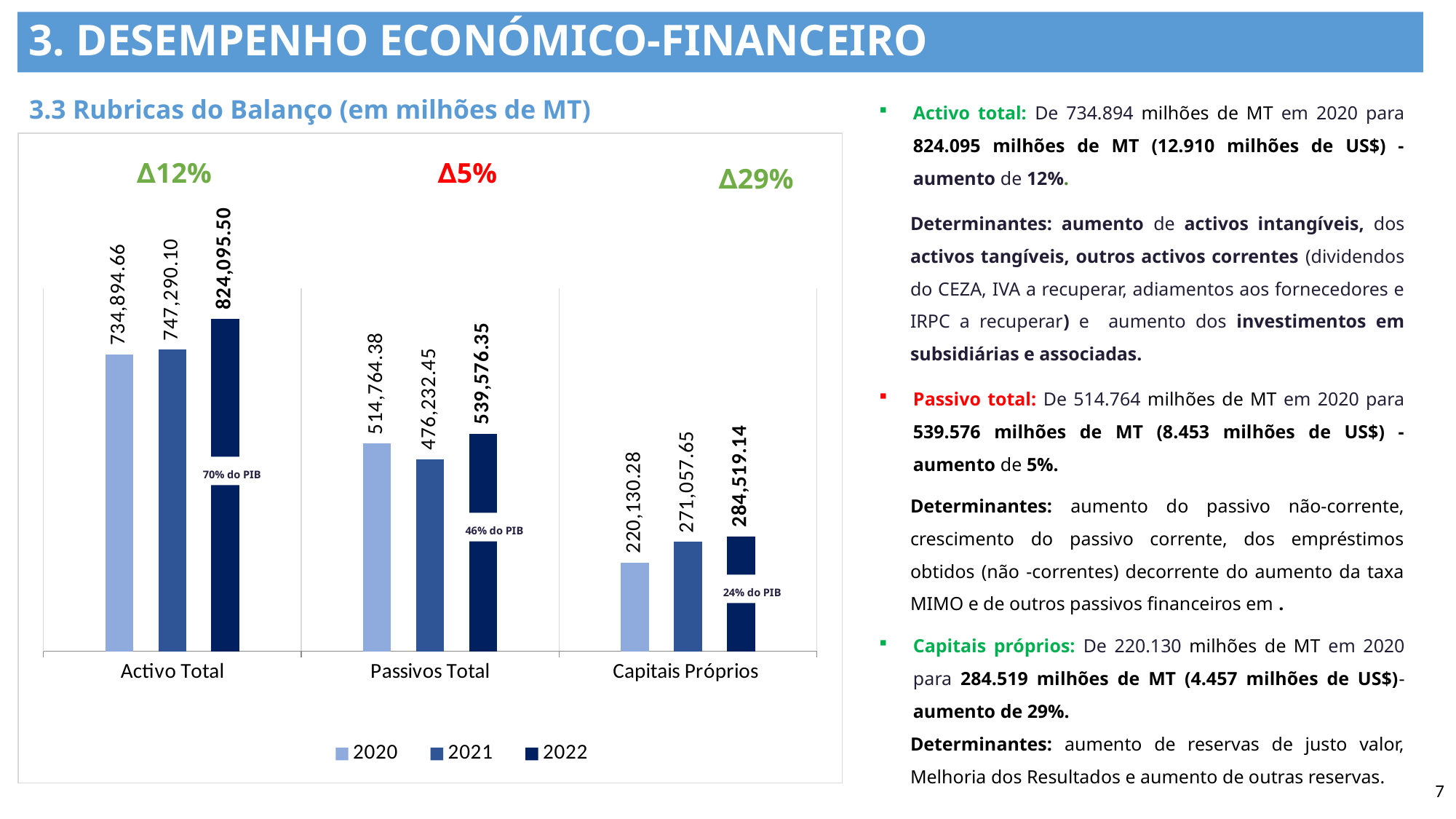
What is the value for Capitais Próprios in 2020? 220,130.28 What kind of chart is shown on the slide? Bar chart How many series does the legend list? 3 Which category has the lowest value in 2020? Capitais Próprios Do the values for Capitais Próprios rise or fall from 2020 to 2022? Rise Which category has the highest value in 2022? Activo Total What is the value for Activo Total in 2022? 824,095.50 How many categories are shown on the x axis? 3 What is the value for Passivos Total in 2021? 476,232.45 What is the difference between the 2022 and 2020 values for Activo Total? 89,200.84 What is the difference between the 2020 and 2021 values for Passivos Total? 38,531.93 Which is larger for Passivos Total: the 2020 value or the 2021 value? 2020